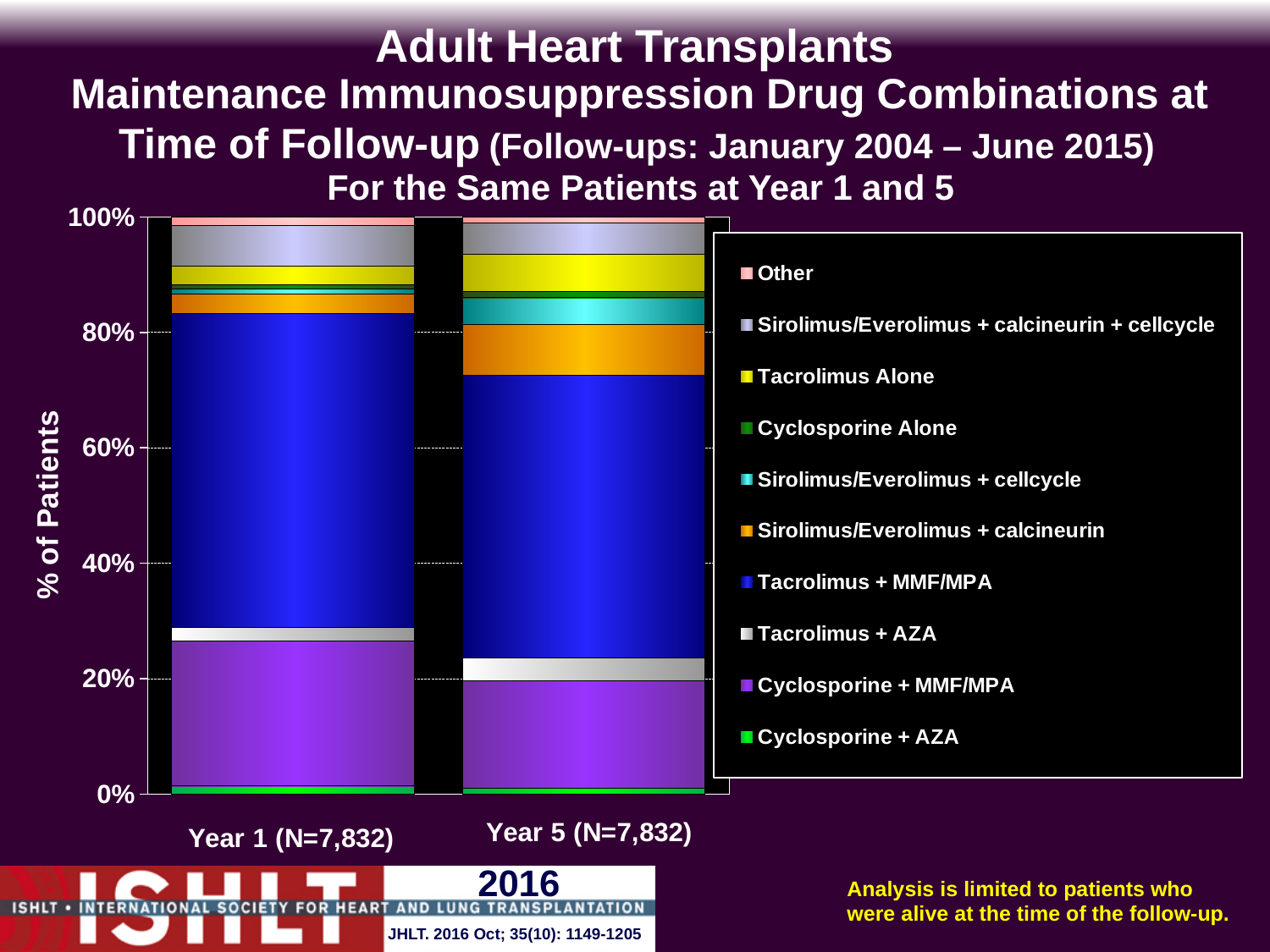
What kind of chart is shown on the slide? Stacked bar chart How many drug combination series does the legend list? 10 How many bars (time points) are plotted in the chart? 2 Is the share of Cyclosporine + MMF/MPA at Year 5 greater or less than 40%? less Which drug combination makes up the largest share of the Year 1 bar? Tacrolimus + MMF/MPA What is the label on the vertical axis of the chart? % of Patients Which drug combination makes up the largest share of the Year 5 bar? Tacrolimus + MMF/MPA Is the share of Sirolimus/Everolimus + calcineurin larger at Year 1 or at Year 5? Year 5 Is the share of Tacrolimus + MMF/MPA at Year 1 greater or less than 40%? greater Does the share of Tacrolimus + MMF/MPA rise or fall from Year 1 to Year 5? fall Is the share of Cyclosporine + MMF/MPA larger at Year 1 or at Year 5? Year 1 What is the N (number of patients) shown for the Year 5 bar? N=7,832